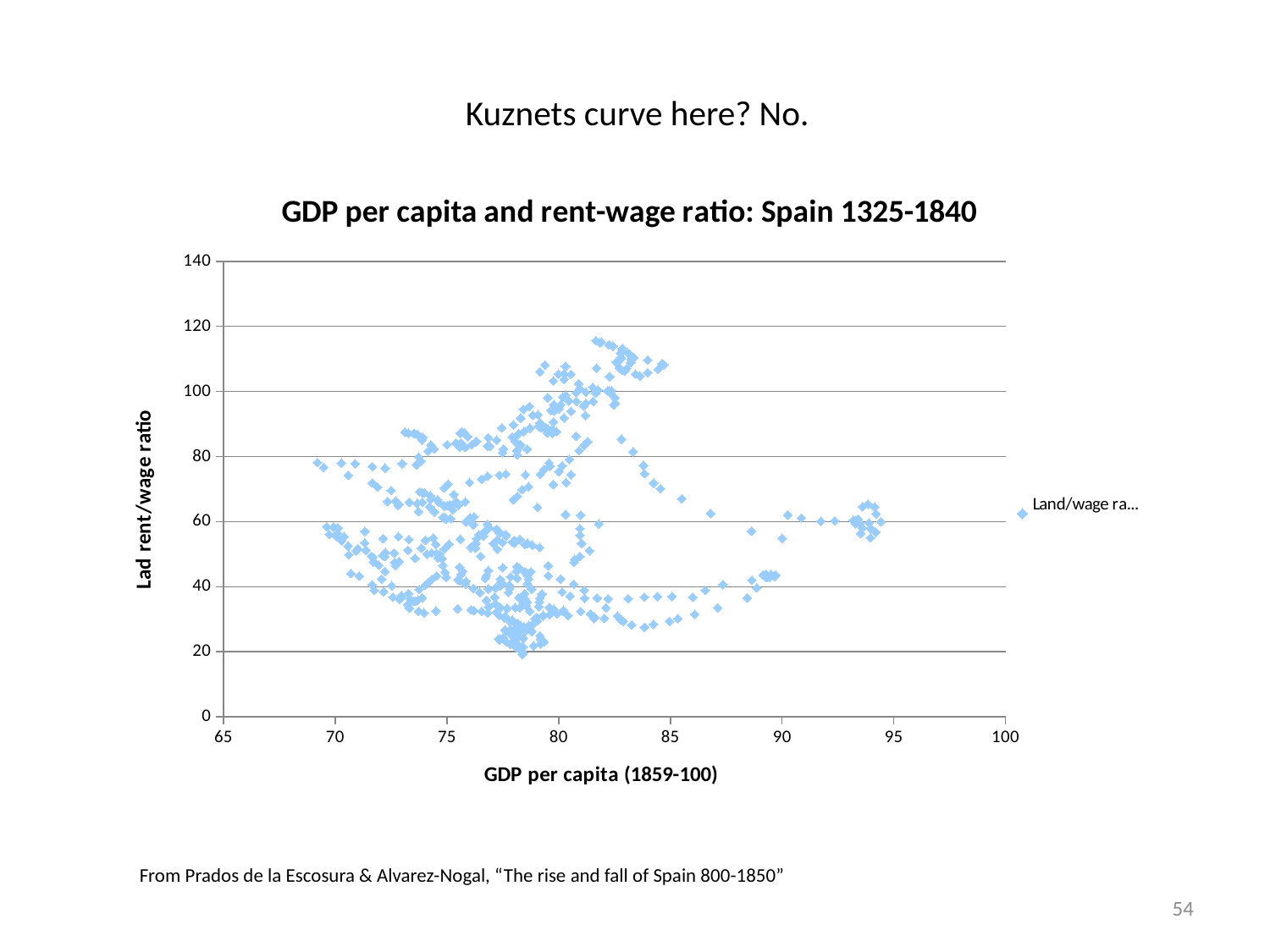
Is the highest rent/wage ratio plotted on the chart greater or less than 100? greater Is the lowest rent/wage ratio plotted on the chart greater or less than 40? less Are any points on the chart plotted above a rent/wage ratio of 120? No What kind of chart is shown on the slide? Scatter chart What is the title of the chart? GDP per capita and rent-wage ratio: Spain 1325-1840 What is the label on the horizontal axis of the chart? GDP per capita (1859-100) What is the maximum value shown on the vertical axis of the chart? 140 How many series does the chart's legend list? 1